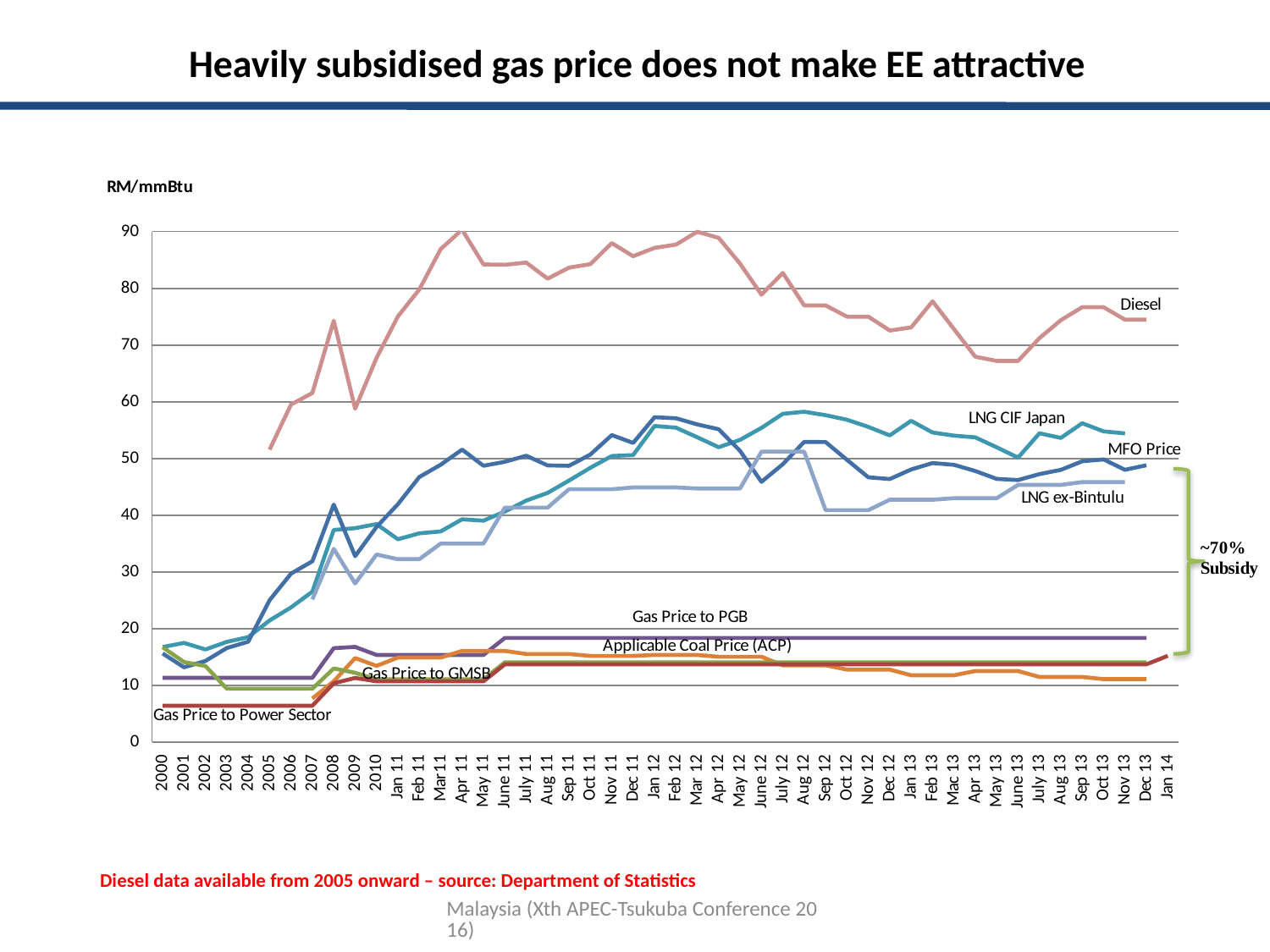
Is the LNG CIF Japan value for Aug 12 greater or less than 50? greater Which is larger at Nov 13, Diesel or LNG CIF Japan? Diesel How many data series are labelled on the chart? 8 Which series has the lowest value in 2000? Gas Price to Power Sector Which is larger at Dec 13, Gas Price to PGB or Applicable Coal Price (ACP)? Gas Price to PGB What kind of chart is shown on the slide? line chart Is the Gas Price to Power Sector value for 2000 greater or less than 10? less Which series has the highest values on the chart? Diesel Is the Diesel value for Nov 13 greater or less than 70? greater Does the Diesel series rise or fall between 2005 and Apr 11? rise What unit is shown on the y axis of the chart? RM/mmBtu